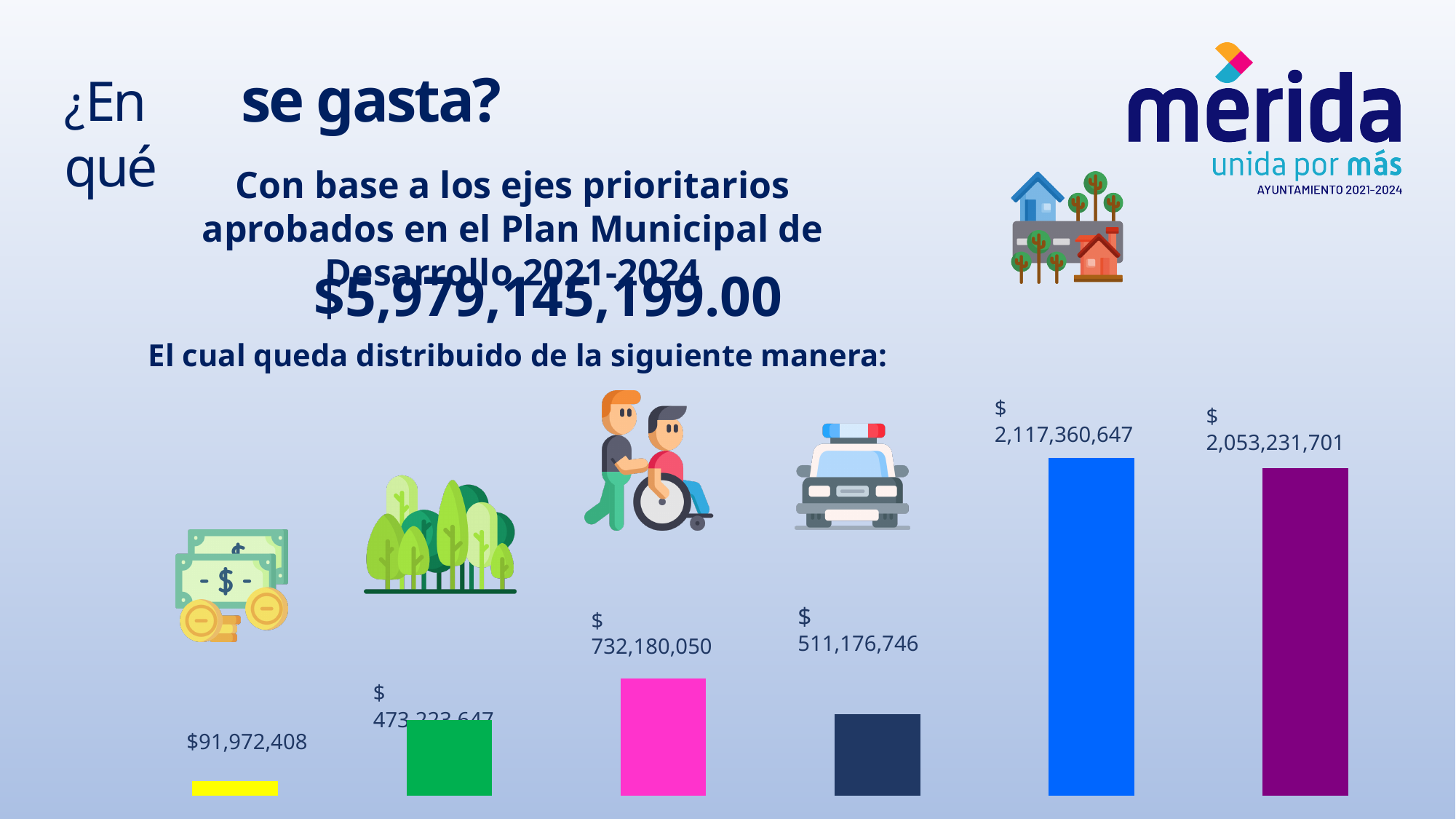
Which bar has the lowest value? the yellow bar, $91,972,408 How many bars does the chart contain? 6 What is the difference between the blue bar ($2,117,360,647) and the purple bar ($2,053,231,701)? $64,128,946 What is the value shown above the pink bar (wheelchair icon)? $732,180,050 What is the value shown above the dark navy bar (police car icon)? $511,176,746 What is the value shown above the blue bar (fifth from the left)? $2,117,360,647 What total amount is stated on the slide as being distributed across the bars? $5,979,145,199.00 What is the value shown above the yellow bar (money icon)? $91,972,408 What kind of chart is shown on the slide? bar chart Which bar has the highest value? the blue bar, $2,117,360,647 What is the value shown above the purple bar (rightmost)? $2,053,231,701 Which is larger, the pink bar or the dark navy bar? the pink bar